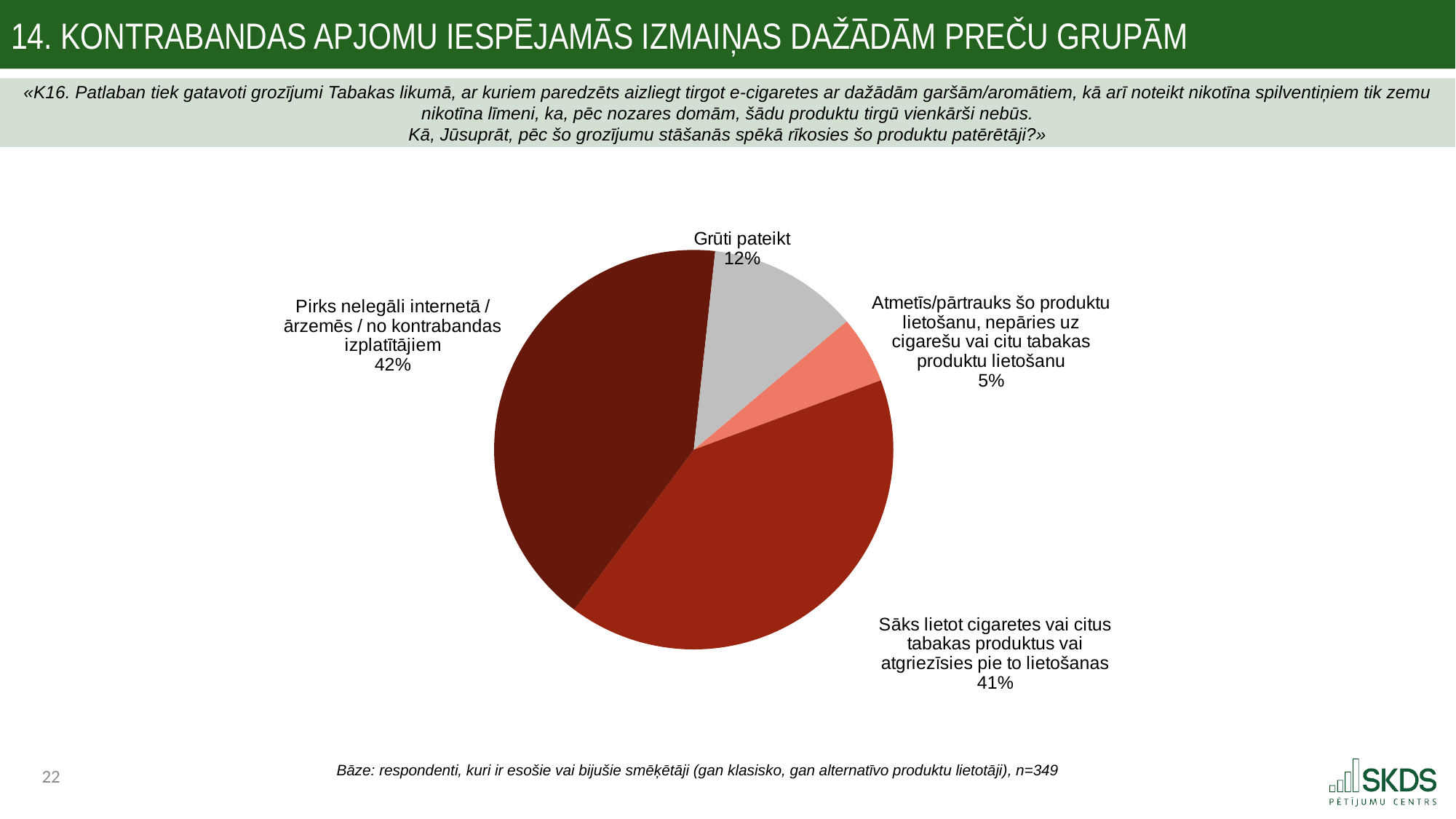
Which response category has the largest share of the pie? Pirks nelegāli internetā / ārzemēs / no kontrabandas izplatītājiem What percentage said they would quit using these products and not switch to cigarettes or other tobacco products (Atmetīs/pārtrauks šo produktu lietošanu...)? 5% What percentage of respondents said they would buy illegally online / abroad / from contraband distributors (Pirks nelegāli internetā / ārzemēs / no kontrabandas izplatītājiem)? 42% What is the difference in percentage points between 'Pirks nelegāli internetā...' and 'Sāks lietot cigaretes vai citus tabakas produktus...'? 1 percentage point What is the sample size (n) stated in the base note below the chart? n=349 Which response category has the smallest share of the pie? Atmetīs/pārtrauks šo produktu lietošanu, nepāries uz cigarešu vai citu tabakas produktu lietošanu What share of respondents answered 'Grūti pateikt'? 12% Which is larger: the share for 'Grūti pateikt' or the share for 'Atmetīs/pārtrauks šo produktu lietošanu...'? Grūti pateikt What is the difference in percentage points between 'Grūti pateikt' and 'Atmetīs/pārtrauks šo produktu lietošanu...'? 7 percentage points What percentage said they would start using cigarettes or other tobacco products or return to them (Sāks lietot cigaretes vai citus tabakas produktus...)? 41% How many slices does the pie chart have? 4 What type of chart is shown on the slide? Pie chart